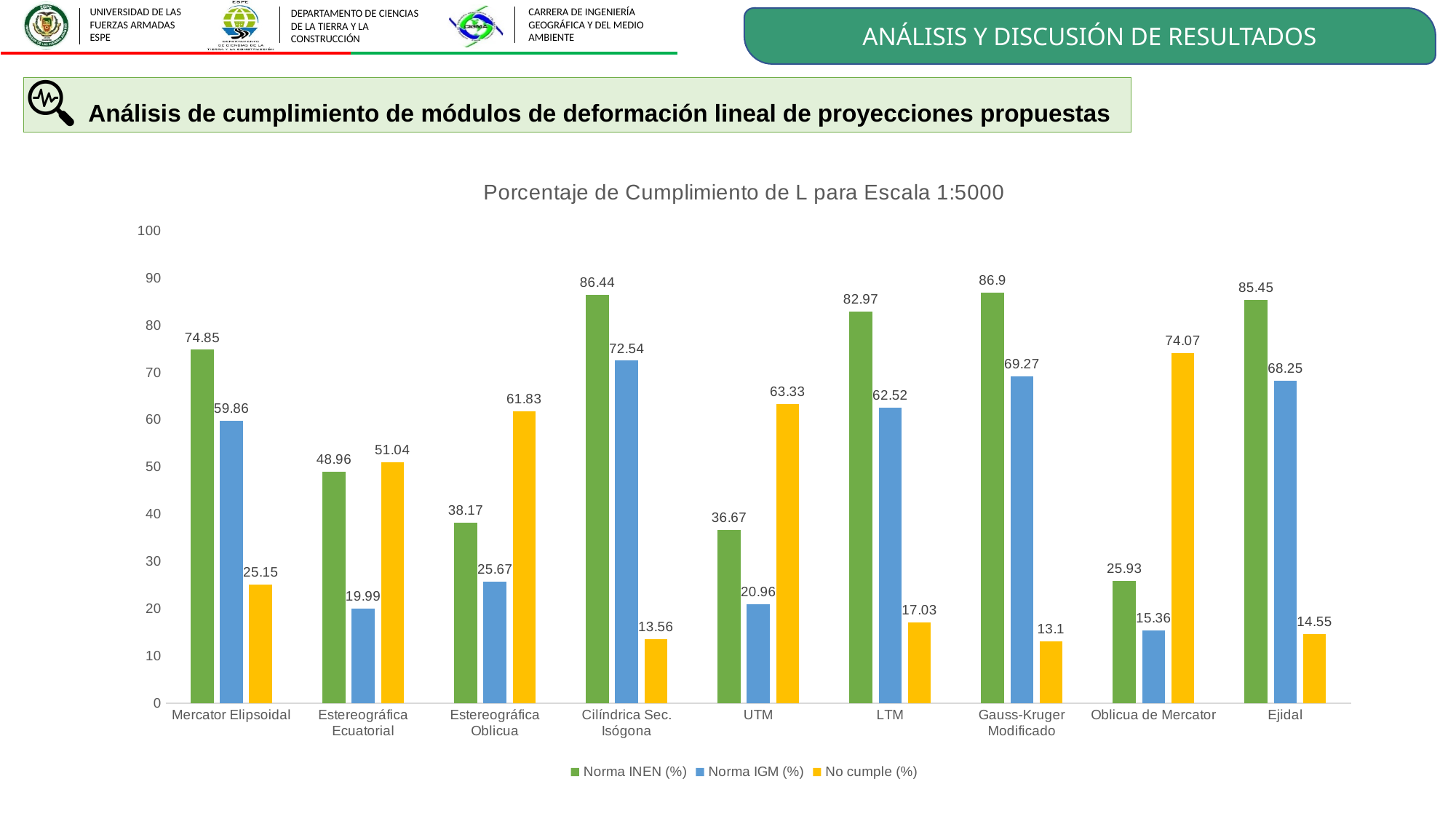
Is the Norma IGM (%) value for LTM greater or less than 60? greater What kind of chart is shown on the slide? Bar chart What is the No cumple (%) value for Oblicua de Mercator? 74.07 Which category has the highest Norma INEN (%) value? Gauss-Kruger Modificado How many projection categories are shown on the x axis? 9 What is the title of the chart? Porcentaje de Cumplimiento de L para Escala 1:5000 What is the Norma INEN (%) value for Cilíndrica Sec. Isógona? 86.44 What is the Norma IGM (%) value for Ejidal? 68.25 How many series does the legend list? 3 Which is larger for Estereográfica Ecuatorial: Norma INEN (%) or No cumple (%)? No cumple (%) What is the difference between the Norma INEN (%) and Norma IGM (%) values for UTM? 15.71 Which category has the lowest No cumple (%) value? Gauss-Kruger Modificado